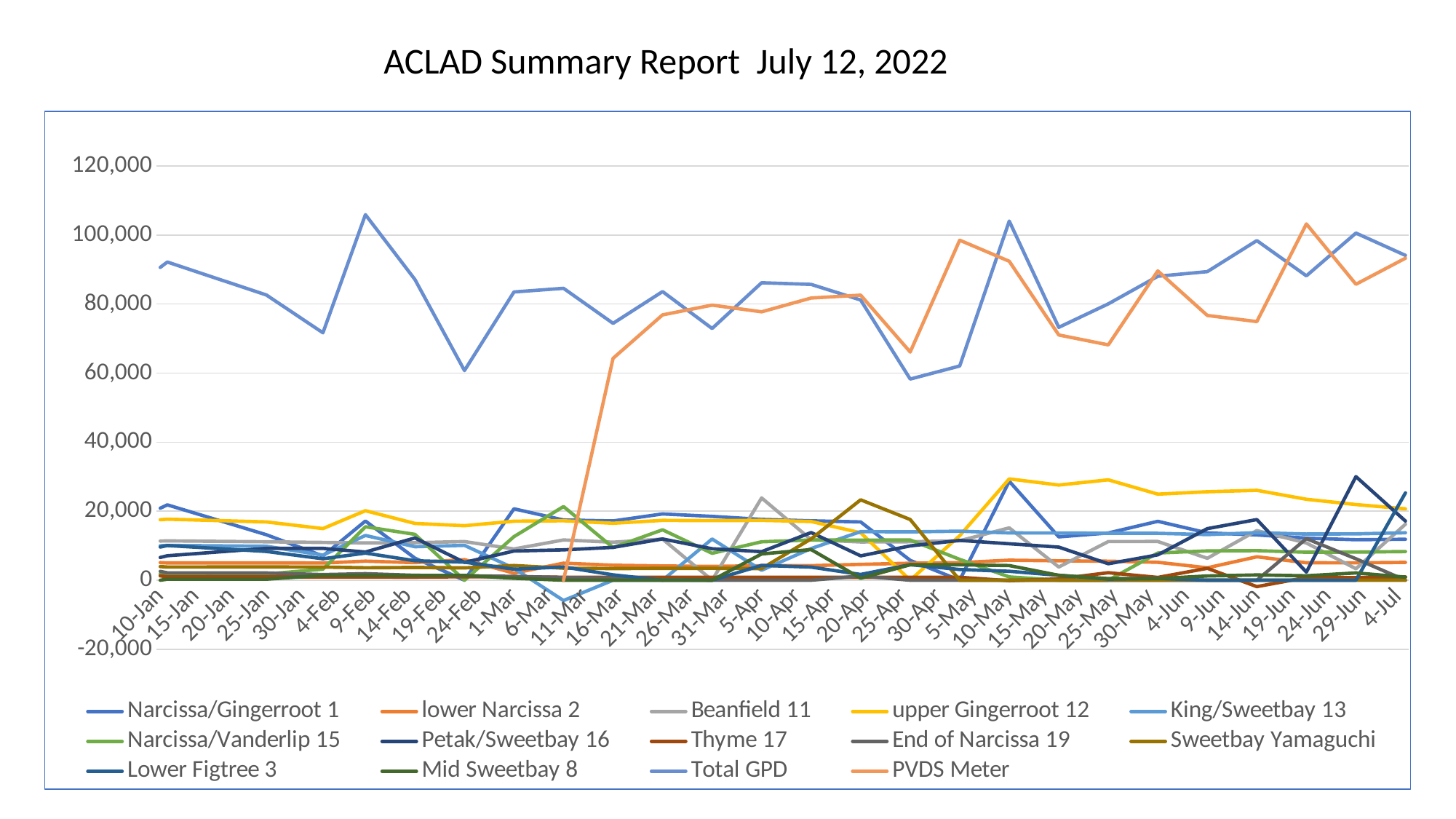
What is the title of the slide? ACLAD Summary Report July 12, 2022 Is the PVDS Meter value on 5-May greater or less than 80,000? greater Is the Total GPD value on 4-Feb greater or less than 80,000? less What is the lowest value labelled on the y axis? -20,000 How many series does the legend list? 14 Does the PVDS Meter line rise or fall between 11-Mar and 16-Mar? rise Is the Total GPD value on 9-Feb greater or less than 100,000? greater Which is larger for Total GPD: the value on 9-Feb or the value on 24-Feb? 9-Feb Does the Total GPD line rise or fall between 9-Feb and 24-Feb? fall How many dates are labelled along the x axis? 36 What kind of chart is shown on the slide? line chart